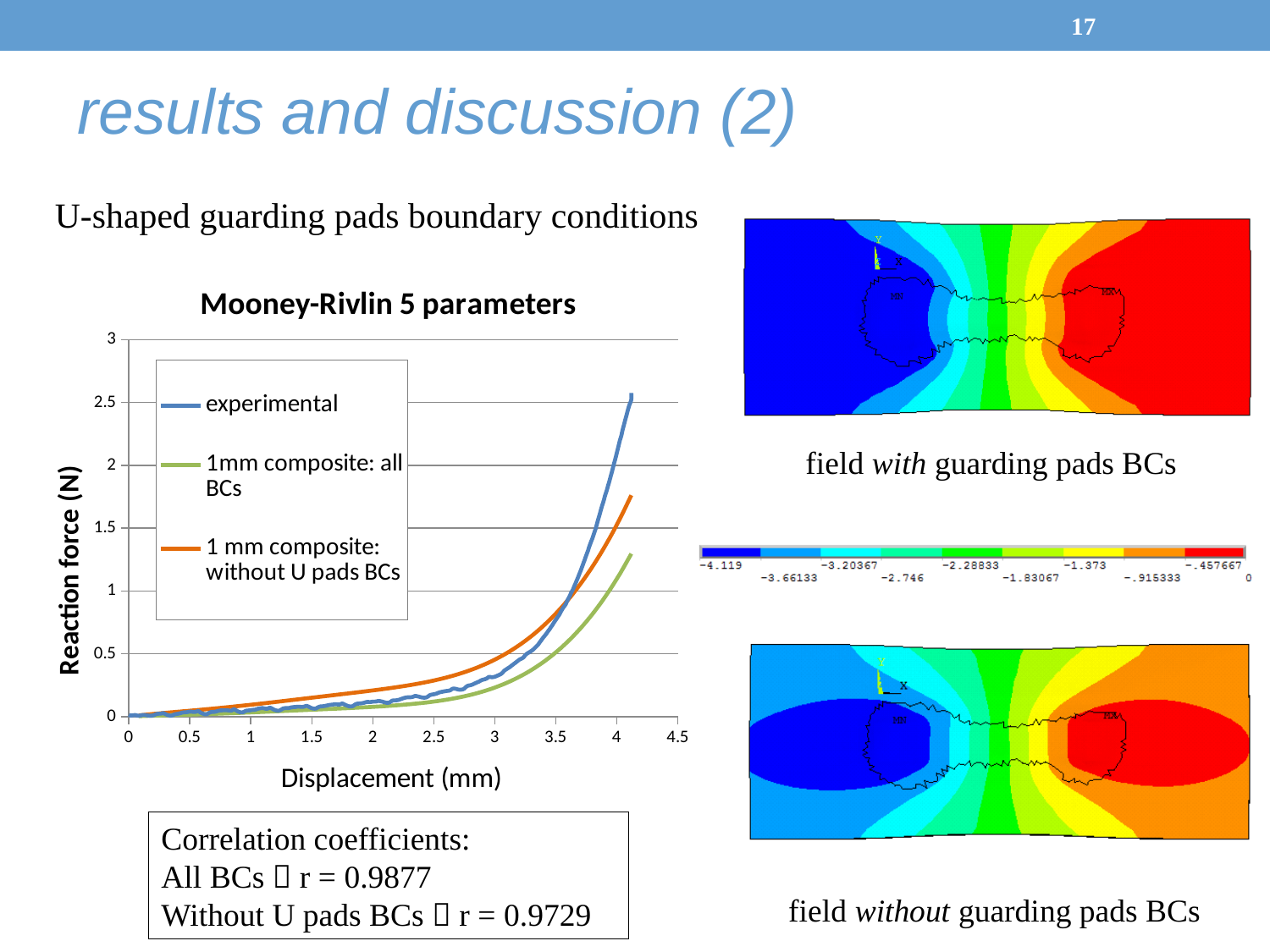
Is the reaction force of the experimental series at a displacement of 2 mm greater or less than 0.5? less At the largest displacement shown, which series has the larger reaction force: 1mm composite: all BCs or 1 mm composite: without U pads BCs? 1 mm composite: without U pads BCs Is the maximum reaction force of the experimental series greater or less than 2? greater What is the title of the chart? Mooney-Rivlin 5 parameters Which series reaches the lowest reaction force at the right end of the chart? 1mm composite: all BCs What is the label of the y axis of the chart? Reaction force (N) Which series reaches the highest reaction force at the right end of the chart? experimental Is the maximum reaction force of the 1 mm composite: without U pads BCs series greater or less than 1.5? greater Do the reaction force values rise or fall as displacement increases along the x axis? rise How many series does the chart's legend list? 3 What kind of chart is shown on the slide? line chart